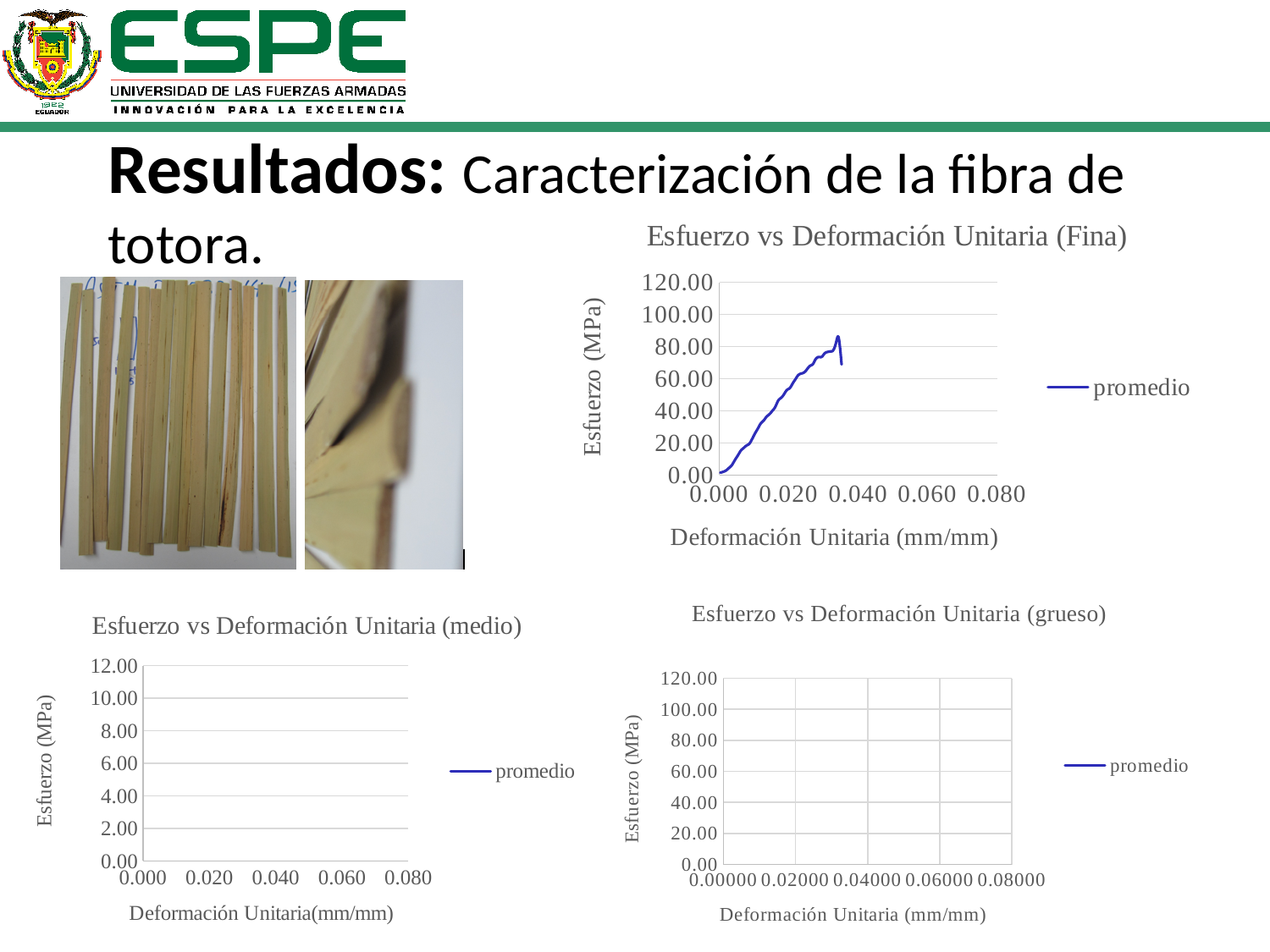
How many charts are shown on the slide? 3 What kind of chart is 'Esfuerzo vs Deformación Unitaria (Fina)'? line chart In the 'Esfuerzo vs Deformación Unitaria (Fina)' chart, does the stress generally rise or fall as the strain increases from 0.000 to about 0.030? rise In the 'Esfuerzo vs Deformación Unitaria (Fina)' chart, is the peak value of the promedio line greater or less than 100.00 MPa? less In the 'Esfuerzo vs Deformación Unitaria (Fina)' chart, is the peak value of the promedio line greater or less than 60.00 MPa? greater What is the name of the series shown in the legend of the 'Esfuerzo vs Deformación Unitaria (medio)' chart? promedio In the 'Esfuerzo vs Deformación Unitaria (Fina)' chart, is the value of the promedio line at a strain of 0.020 greater or less than 20.00 MPa? greater What is the highest tick value on the y axis of the 'Esfuerzo vs Deformación Unitaria (medio)' chart? 12.00 How many series does the legend of the 'Esfuerzo vs Deformación Unitaria (Fina)' chart list? 1